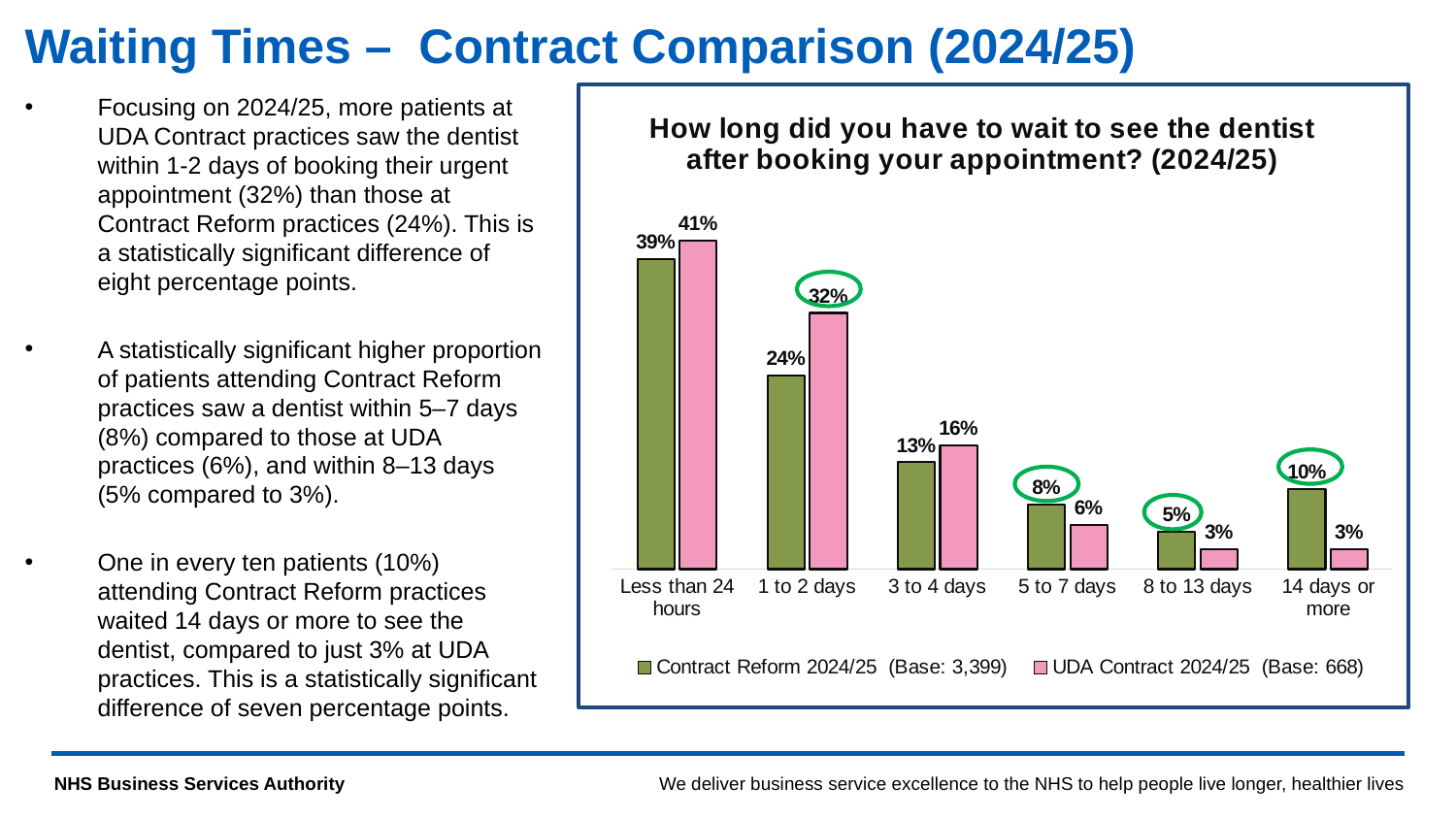
Which waiting time category has the lowest value for Contract Reform 2024/25? 8 to 13 days What kind of chart is shown on the slide? Bar chart What is the value for UDA Contract 2024/25 in the 14 days or more category? 3% What is the base (number of respondents) for the Contract Reform 2024/25 series shown in the legend? 3,399 What percentage of Contract Reform 2024/25 patients waited 1 to 2 days to see the dentist? 24% How many series does the legend list? 2 Which waiting time category has the highest value for Contract Reform 2024/25? Less than 24 hours What percentage of UDA Contract 2024/25 patients waited less than 24 hours? 41% Which series has the larger value for 3 to 4 days, Contract Reform 2024/25 or UDA Contract 2024/25? UDA Contract 2024/25 What is the difference between Contract Reform and UDA Contract for 14 days or more? 7 percentage points How many waiting time categories are shown on the x axis? 6 What is the difference between the UDA Contract and Contract Reform values for 1 to 2 days? 8 percentage points